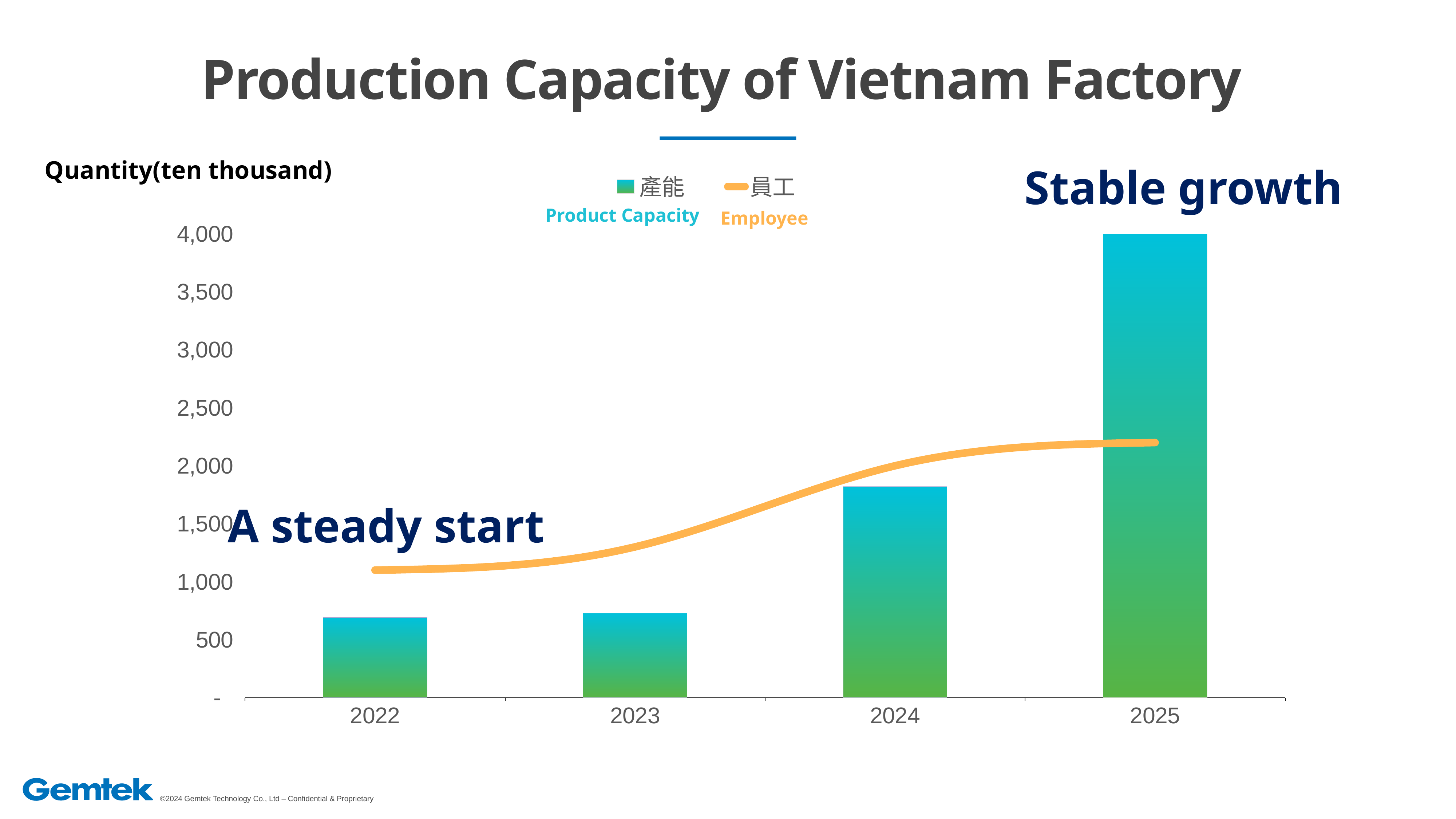
Do the Product Capacity bars rise or fall from 2022 to 2025? rise How many series does the chart's legend list? 2 Which is larger, the Product Capacity for 2023 or for 2024? 2024 Is the Product Capacity value for 2024 greater or less than 2,000? less Is the Employee value for 2025 greater or less than 2,000? greater Which year has the highest Product Capacity bar? 2025 How many years are shown on the x axis of the chart? 4 What kind of chart is shown on the slide? A bar chart with a line series What unit is given for the quantity axis of the chart? ten thousand Is the Product Capacity value for 2024 greater or less than 1,500? greater